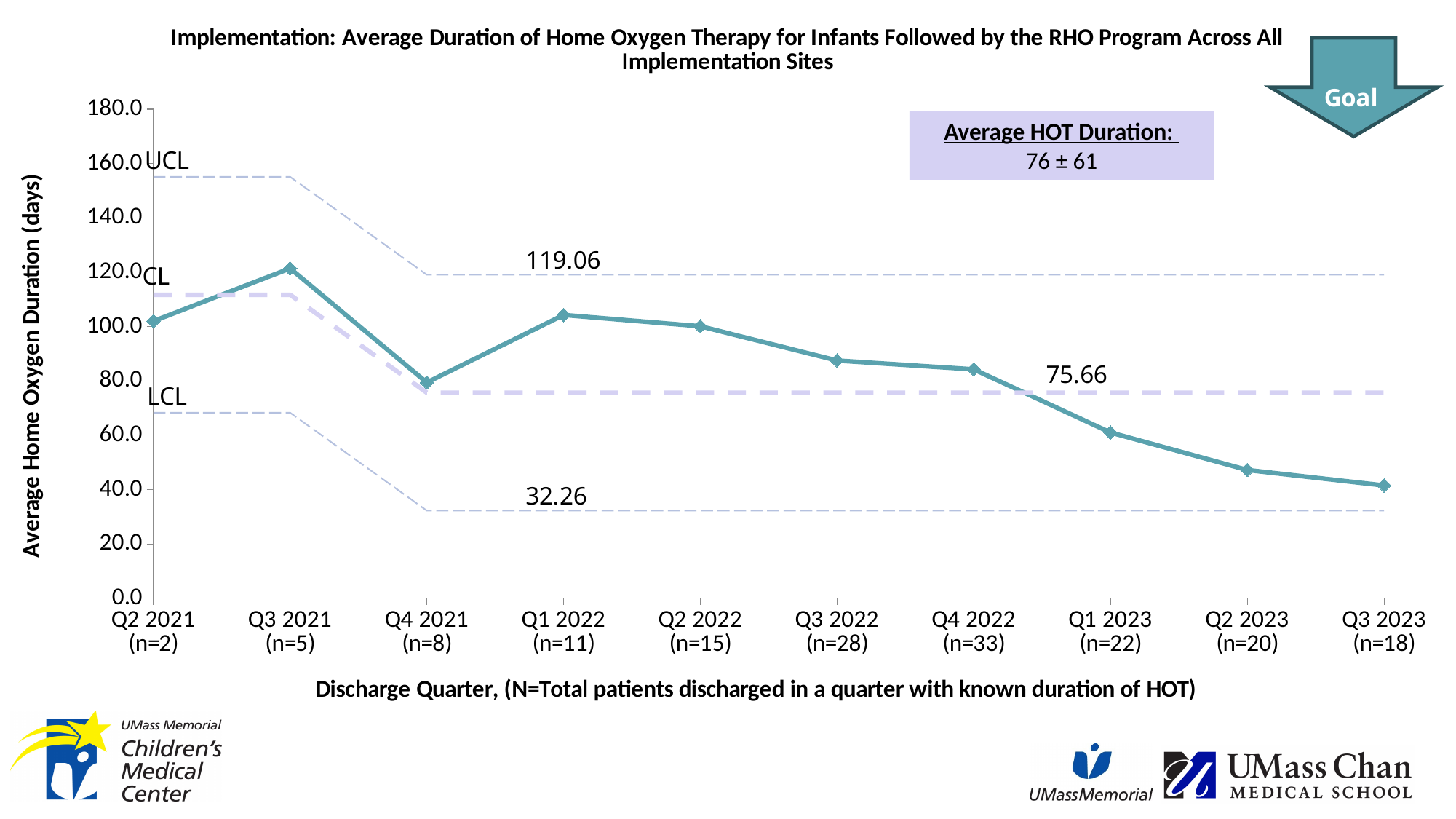
What value is labelled for the upper control limit (UCL) line after Q4 2021? 119.06 Which discharge quarter has the highest average home oxygen duration? Q3 2021 How many discharge quarters are plotted on the x axis? 10 What value is labelled for the lower control limit (LCL) line after Q4 2021? 32.26 Which has a larger average home oxygen duration, Q1 2023 or Q2 2023? Q1 2023 What kind of chart is shown on the slide? line chart What value is labelled for the center line (CL) after Q4 2021? 75.66 What Average HOT Duration is stated in the box on the slide? 76 ± 61 Which discharge quarter has the lowest average home oxygen duration? Q3 2023 Is the average home oxygen duration for Q3 2021 greater or less than 100? greater From Q1 2022 to Q3 2023, do the plotted values rise or fall? fall Is the average home oxygen duration for Q2 2023 greater or less than 60? less